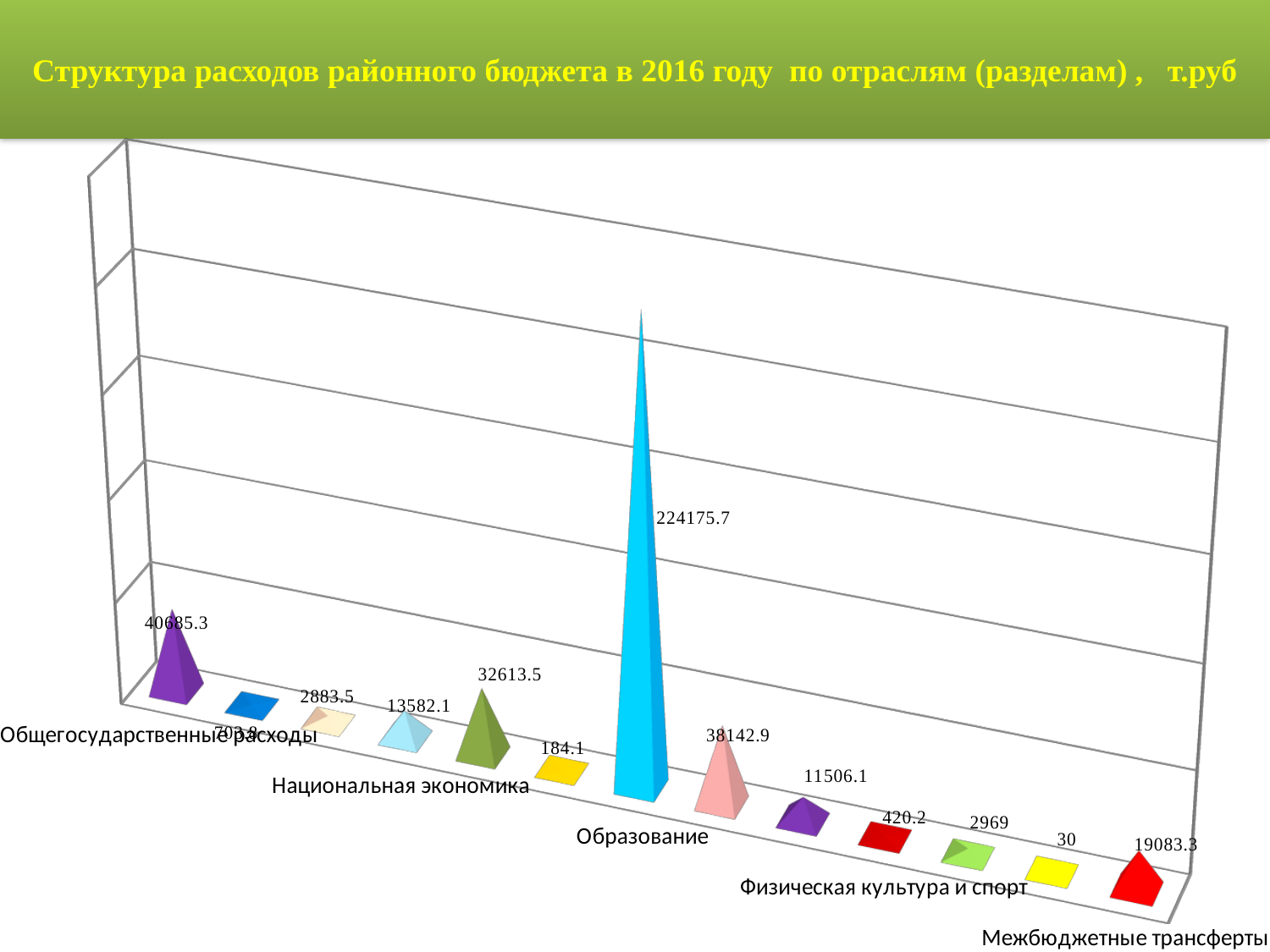
What is the value for Межбюджетные трансферты? 19083.3 What is the value for Образование? 224175.7 What is the value for Физическая культура и спорт? 420.2 What kind of chart is shown on the slide? Bar chart What is the title of the chart? Структура расходов районного бюджета в 2016 году по отраслям (разделам), т.руб Which category has the highest value? Образование What is the value for Общегосударственные расходы? 40685.3 What is the difference between the values for Образование and Общегосударственные расходы? 183490.4 How many categories are plotted on the chart? 13 What is the smallest value shown on the chart? 30 What is the value for Национальная экономика? 13582.1 Which is larger, the value for Межбюджетные трансферты or the value for Национальная экономика? Межбюджетные трансферты